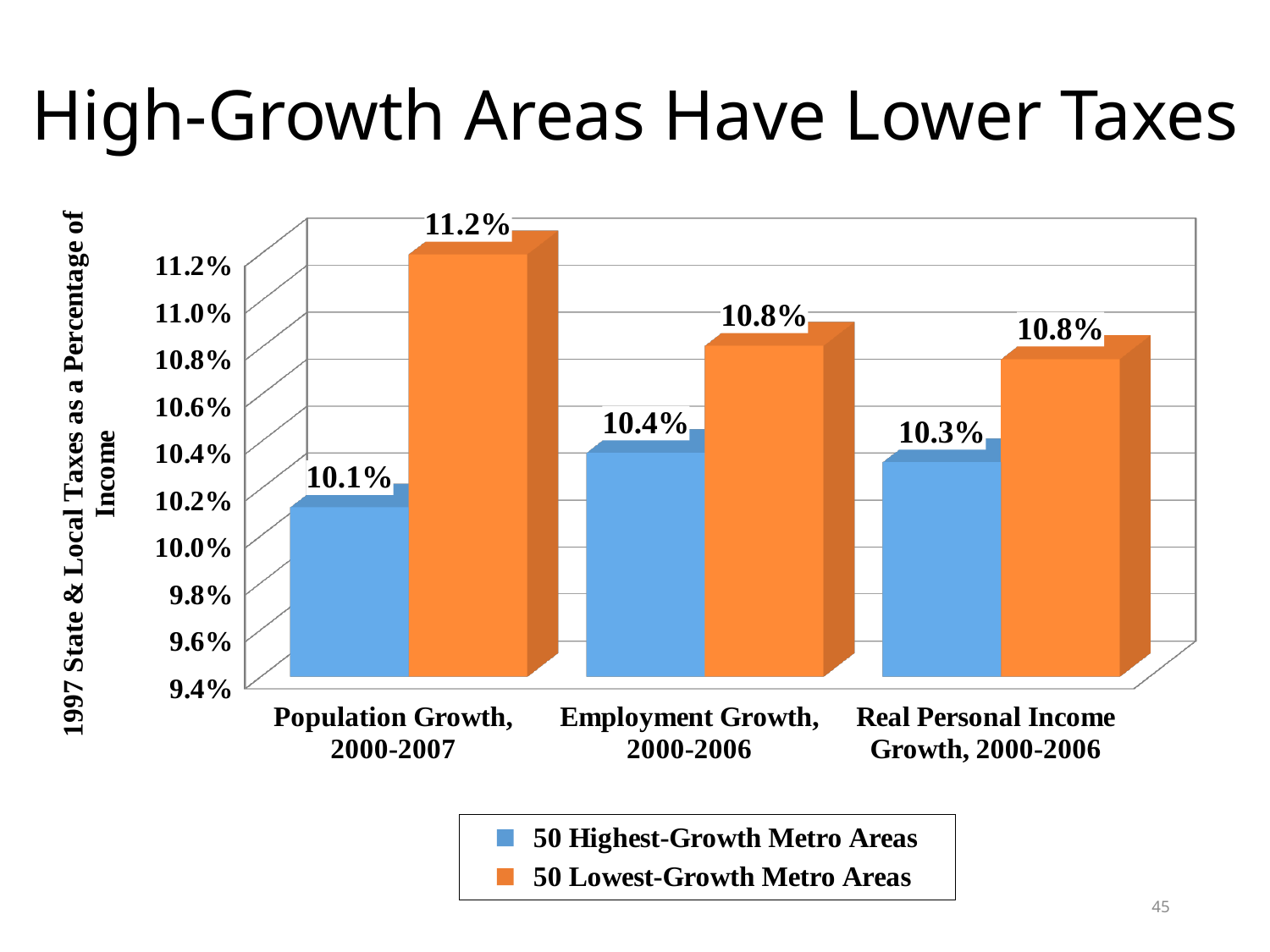
What type of chart is shown on the slide? Bar chart Which category has the highest value for the 50 Lowest-Growth Metro Areas? Population Growth, 2000-2007 Under Employment Growth, 2000-2006, which series has the larger value? 50 Lowest-Growth Metro Areas Which category has the lowest value for the 50 Highest-Growth Metro Areas? Population Growth, 2000-2007 What is the value for the 50 Lowest-Growth Metro Areas under Real Personal Income Growth, 2000-2006? 10.8% How many series does the legend list? 2 What is the difference between the 50 Lowest-Growth and 50 Highest-Growth Metro Areas under Population Growth, 2000-2007? 1.1% What is the value for the 50 Highest-Growth Metro Areas under Population Growth, 2000-2007? 10.1% How many categories are shown on the x axis? 3 What is the value for the 50 Lowest-Growth Metro Areas under Population Growth, 2000-2007? 11.2% What is the difference between the 50 Lowest-Growth and 50 Highest-Growth Metro Areas under Real Personal Income Growth, 2000-2006? 0.5% What is the value for the 50 Highest-Growth Metro Areas under Employment Growth, 2000-2006? 10.4%